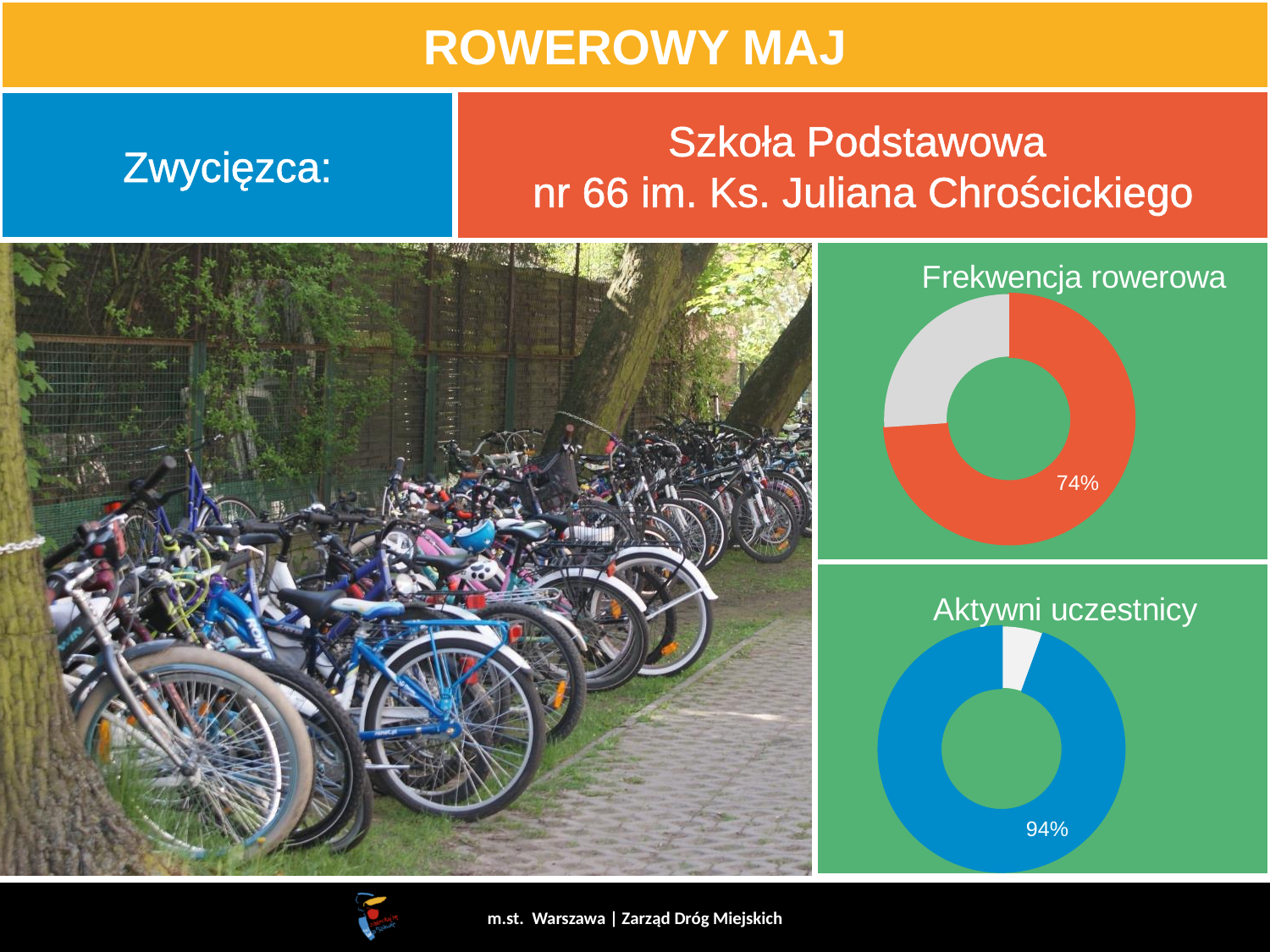
Which chart shows the larger labelled percentage, 'Frekwencja rowerowa' or 'Aktywni uczestnicy'? Aktywni uczestnicy What is the title of the upper chart on the right side of the slide? Frekwencja rowerowa In the 'Aktywni uczestnicy' chart, what value is printed on the blue slice? 94% What is the difference between the labelled value in the 'Aktywni uczestnicy' chart and the labelled value in the 'Frekwencja rowerowa' chart? 20 percentage points How many slices does the 'Frekwencja rowerowa' donut chart have? 2 What colour is the large slice in the 'Aktywni uczestnicy' chart? Blue How many slices does the 'Aktywni uczestnicy' donut chart have? 2 In the 'Aktywni uczestnicy' chart, what share of the donut does the blue slice represent? 94% In the 'Frekwencja rowerowa' chart, what value is printed on the orange slice? 74% In the 'Frekwencja rowerowa' chart, what share of the donut does the orange slice represent? 74% What kind of chart is the 'Aktywni uczestnicy' chart? Donut (pie) chart What kind of chart is the 'Frekwencja rowerowa' chart? Donut (pie) chart